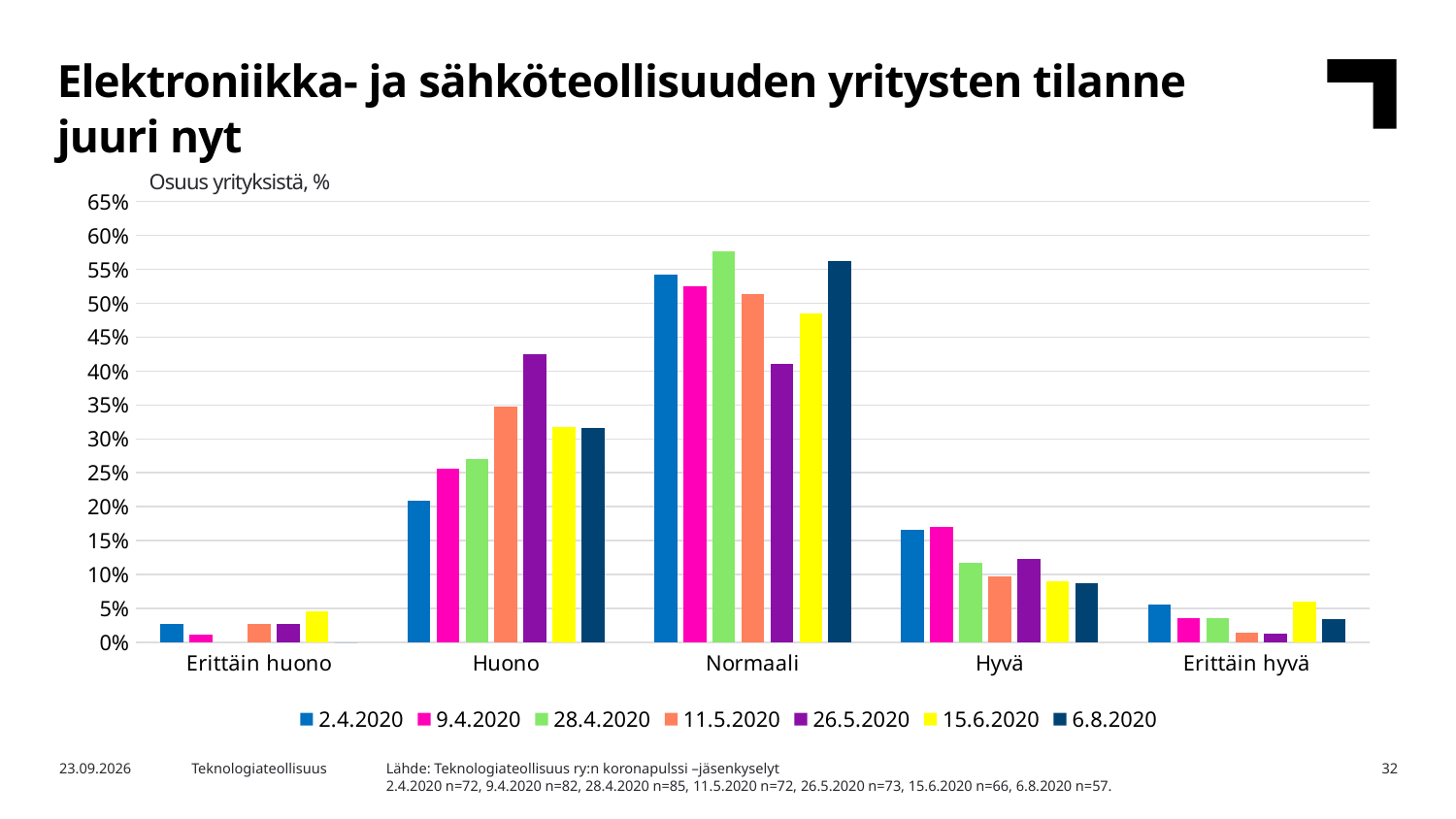
What label is shown above the vertical axis? Osuus yrityksistä, % Which category has the highest bars overall? Normaali How many series does the legend list? 7 How many categories are shown on the x axis? 5 Is the value for 26.5.2020 in the Huono category greater or less than 40%? greater For the 2.4.2020 series, which is larger: the Normaali value or the Huono value? Normaali Is the value for 26.5.2020 in the Normaali category greater or less than 45%? less Is the value for 2.4.2020 in the Huono category greater or less than 25%? less In the Huono category, which series has the lowest bar? 2.4.2020 In the Hyvä category, which is larger: the value for 2.4.2020 or the value for 6.8.2020? 2.4.2020 What kind of chart is shown on the slide? bar chart In the Huono category, which series has the highest bar? 26.5.2020